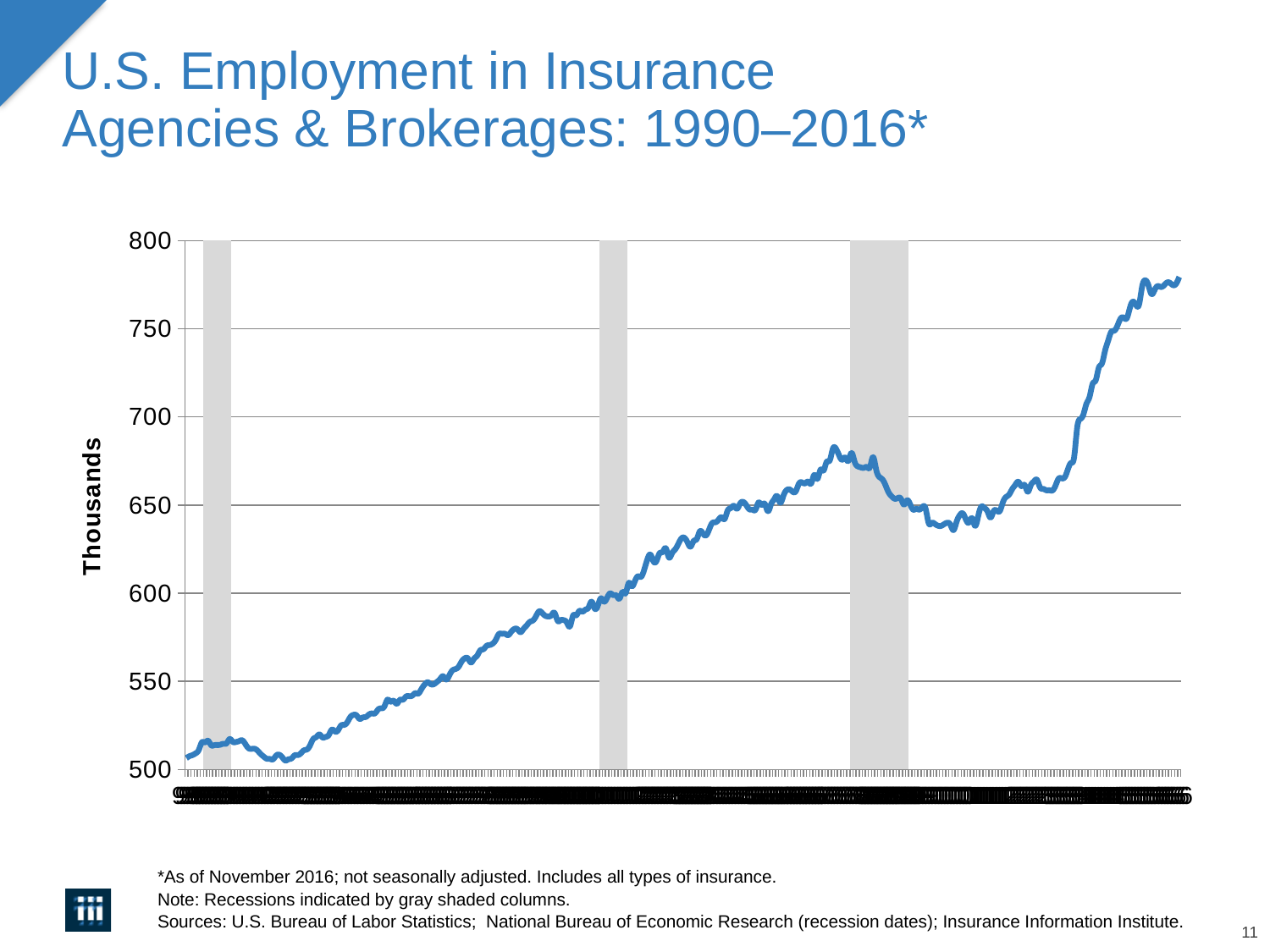
What is the label on the vertical axis? Thousands Does the line rise or fall between the second and third gray shaded columns? rise How many gray shaded columns (recessions) appear on the chart? 3 Does the line rise or fall during the third gray shaded column? fall Does the line rise or fall over the final portion of the series after the third gray shaded column? rise Is the low point reached after the third gray shaded column greater or less than 650? less Is the peak reached just before the third gray shaded column greater or less than 650? greater Is the value at the end of the series (right end of the line) greater or less than 750? greater What kind of chart is shown on the slide? line chart Is the value at the end of the series greater or less than the value at the start of the series? greater